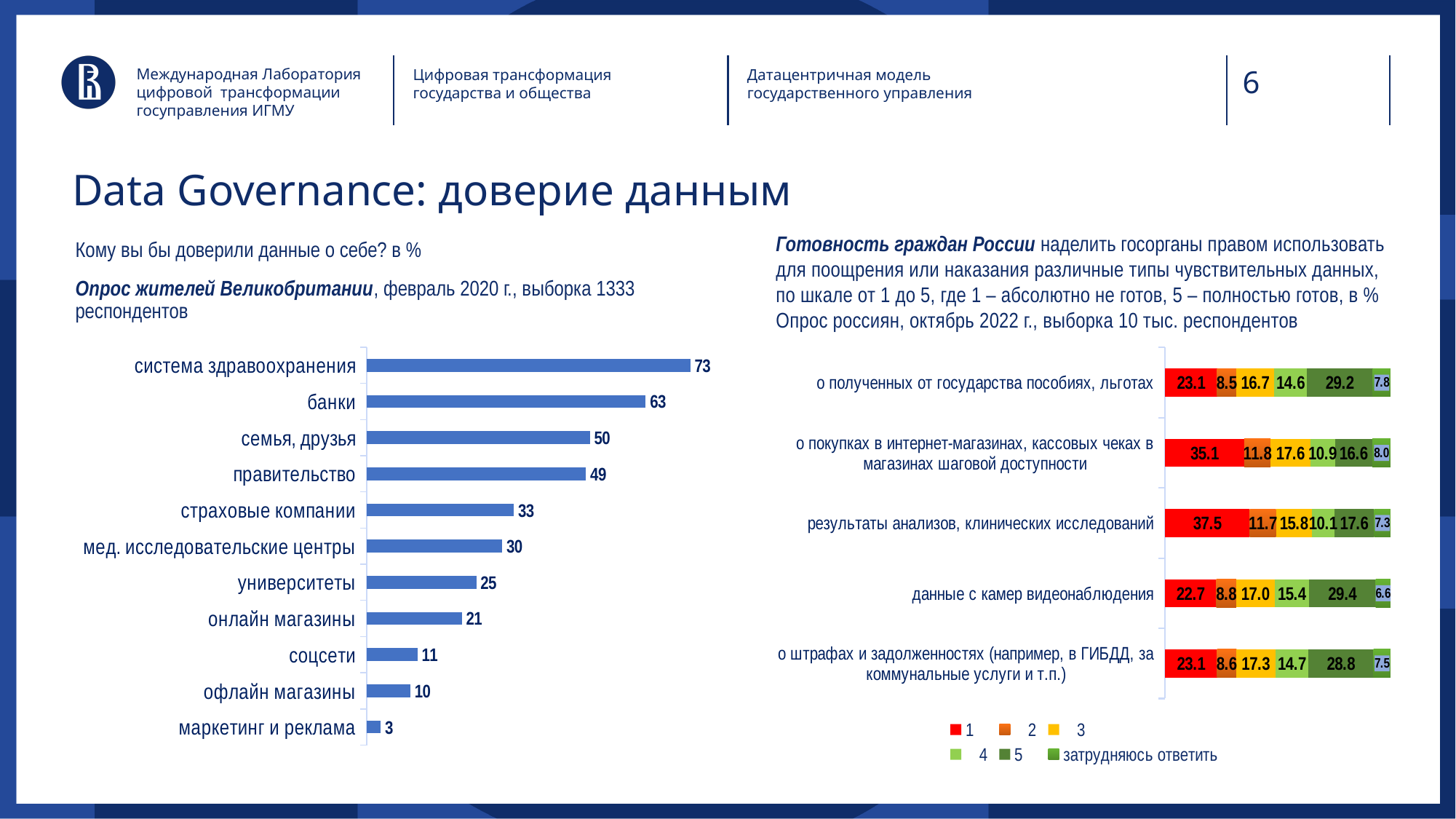
In the right chart (Готовность граждан России), which category has the highest value for series 1? результаты анализов, клинических исследований In the left chart (Кому вы бы доверили данные о себе?), what is the difference between семья, друзья and правительство? 1 In the right chart (Готовность граждан России), what is the difference between series 5 for о полученных от государства пособиях, льготах and series 5 for о штрафах и задолженностях? 0.4 In the left chart (Кому вы бы доверили данные о себе?), which is larger: страховые компании or университеты? страховые компании In the right chart (Готовность граждан России), how many series does the legend list? 6 In the left chart (Кому вы бы доверили данные о себе?), how many categories are shown? 11 In the left chart (Кому вы бы доверили данные о себе?), which category has the lowest value? маркетинг и реклама In the right chart (Готовность граждан России), what is the value of series 1 for результаты анализов, клинических исследований? 37.5 What kind of chart is the left chart (Кому вы бы доверили данные о себе?)? bar chart In the left chart (Кому вы бы доверили данные о себе?), what is the value for банки? 63 In the left chart (Кому вы бы доверили данные о себе?), which category has the highest value? система здравоохранения In the right chart (Готовность граждан России), what is the value of series 5 for данные с камер видеонаблюдения? 29.4